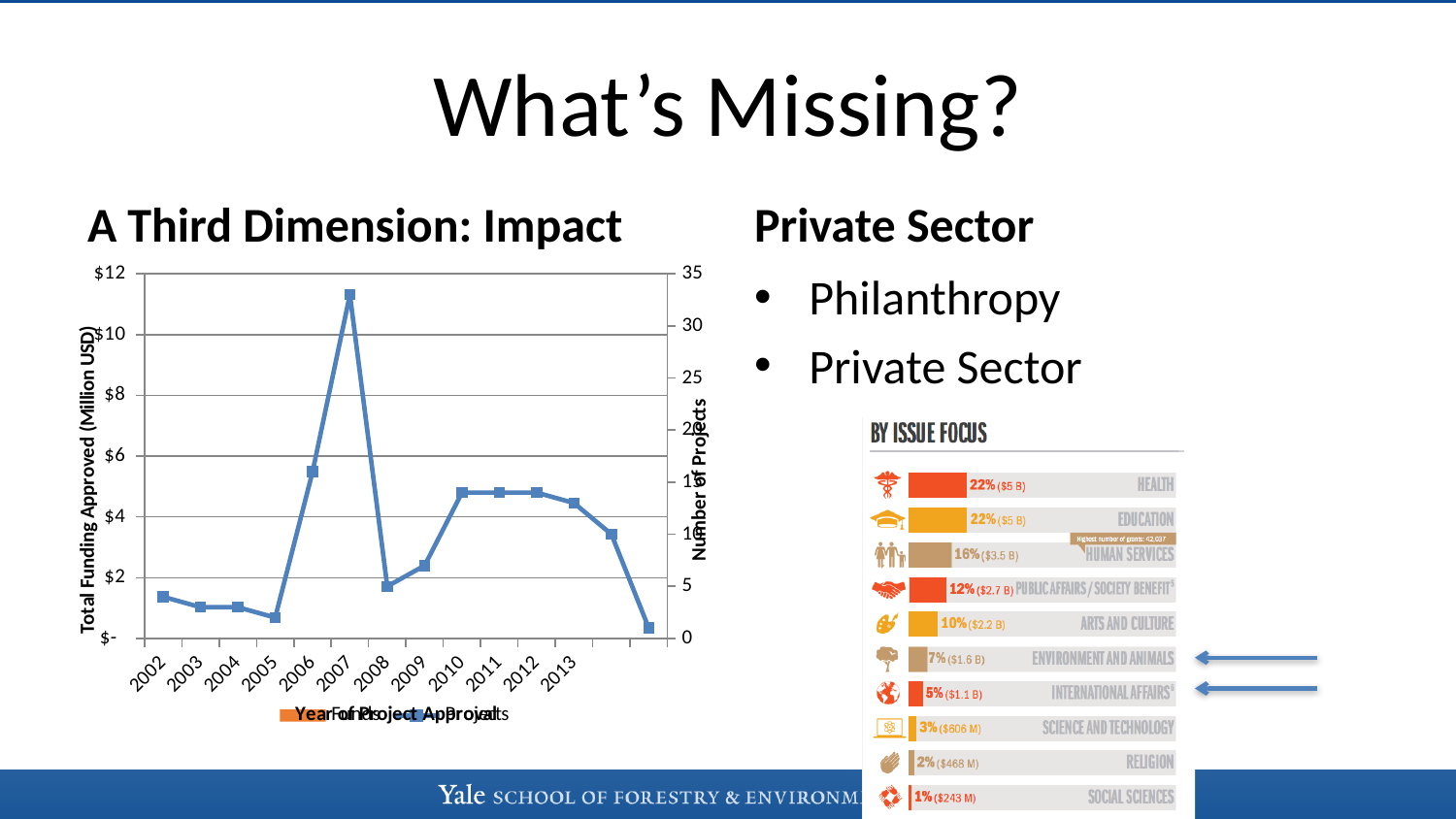
In the line chart under 'A Third Dimension: Impact', is the value for 2006 on the Number of Projects axis greater or less than 10? greater In the line chart under 'A Third Dimension: Impact', is the value for 2007 on the Number of Projects axis greater or less than 30? greater How many issue categories are listed in the 'BY ISSUE FOCUS' chart? 10 In the 'BY ISSUE FOCUS' chart, which issue has the lowest percentage? Social Sciences In the 'BY ISSUE FOCUS' chart, what is the difference in percentage points between Health and Environment and Animals? 15 In the line chart under 'A Third Dimension: Impact', is the value for 2005 on the Number of Projects axis greater or less than 5? less In the 'BY ISSUE FOCUS' chart, what dollar amount is shown for Environment and Animals? $1.6 B In the line chart under 'A Third Dimension: Impact', which is larger, the value for 2007 or the value for 2008? 2007 In the line chart under 'A Third Dimension: Impact', which year has the highest plotted value? 2007 In the 'BY ISSUE FOCUS' chart, what percentage is shown for Health? 22% What kind of chart is the chart under 'A Third Dimension: Impact'? line chart In the line chart under 'A Third Dimension: Impact', what is the label of the right-hand vertical axis? Number of Projects